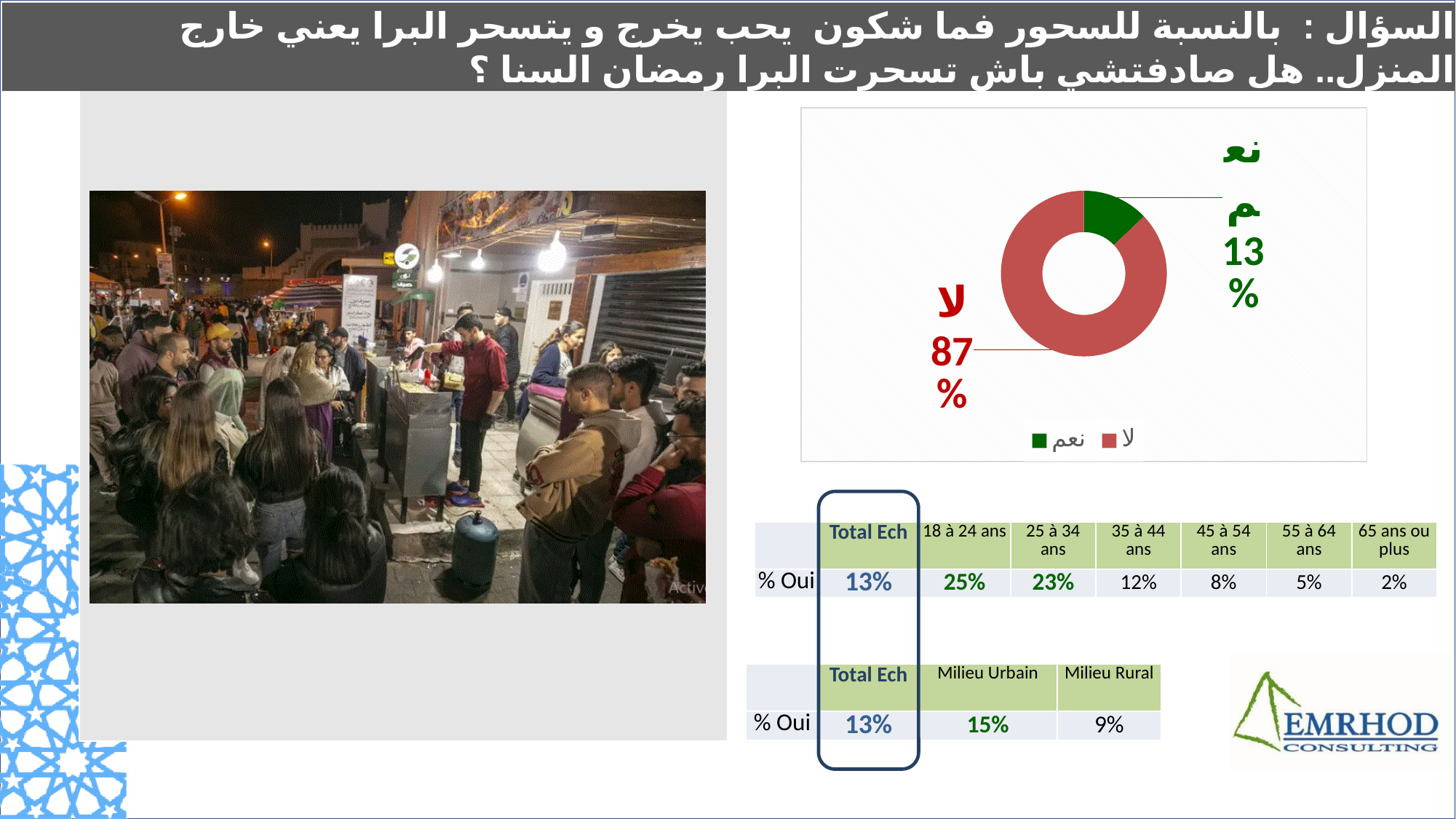
What colour is the نعم slice in the donut chart? Green What percentage does the slice labelled لا show? 87% What colour is the لا slice in the donut chart? Red What percentage does the slice labelled نعم show? 13% What kind of chart is shown on the slide? Donut (pie) chart Which is larger, the نعم slice or the لا slice? لا Which slice is the smallest in the donut chart? نعم How many entries does the chart legend list? 2 What is the difference in percentage points between the لا slice and the نعم slice? 74 How many slices does the donut chart have? 2 What share of the donut chart does the لا slice represent? 87% Which slice is the largest in the donut chart? لا